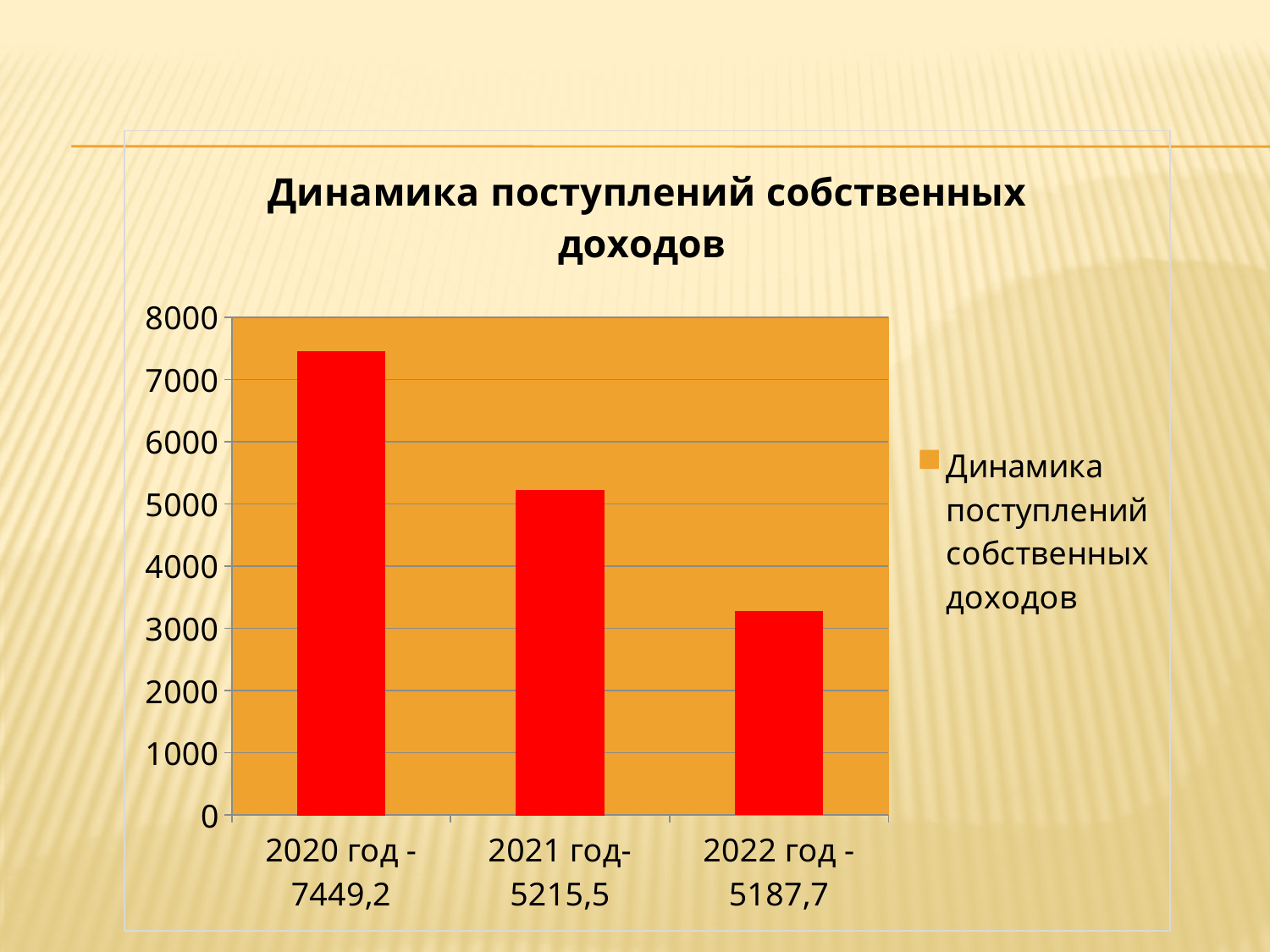
Which year has the highest bar? 2020 год What is the difference between the values for 2020 год (7449,2) and 2021 год (5215,5)? 2233,7 What value is given for 2020 год in the category label? 7449,2 What kind of chart is shown on the slide? bar chart Do the bars rise or fall from 2020 to 2022 along the x axis? fall How many bars (categories) does the chart show? 3 What is the title of the chart? Динамика поступлений собственных доходов What value is given for 2021 год in the category label? 5215,5 Which is larger, the bar for 2020 год or the bar for 2021 год? 2020 год Which year has the lowest bar? 2022 год How many series does the legend list? 1 Is the value for 2020 год greater or less than 7000? greater